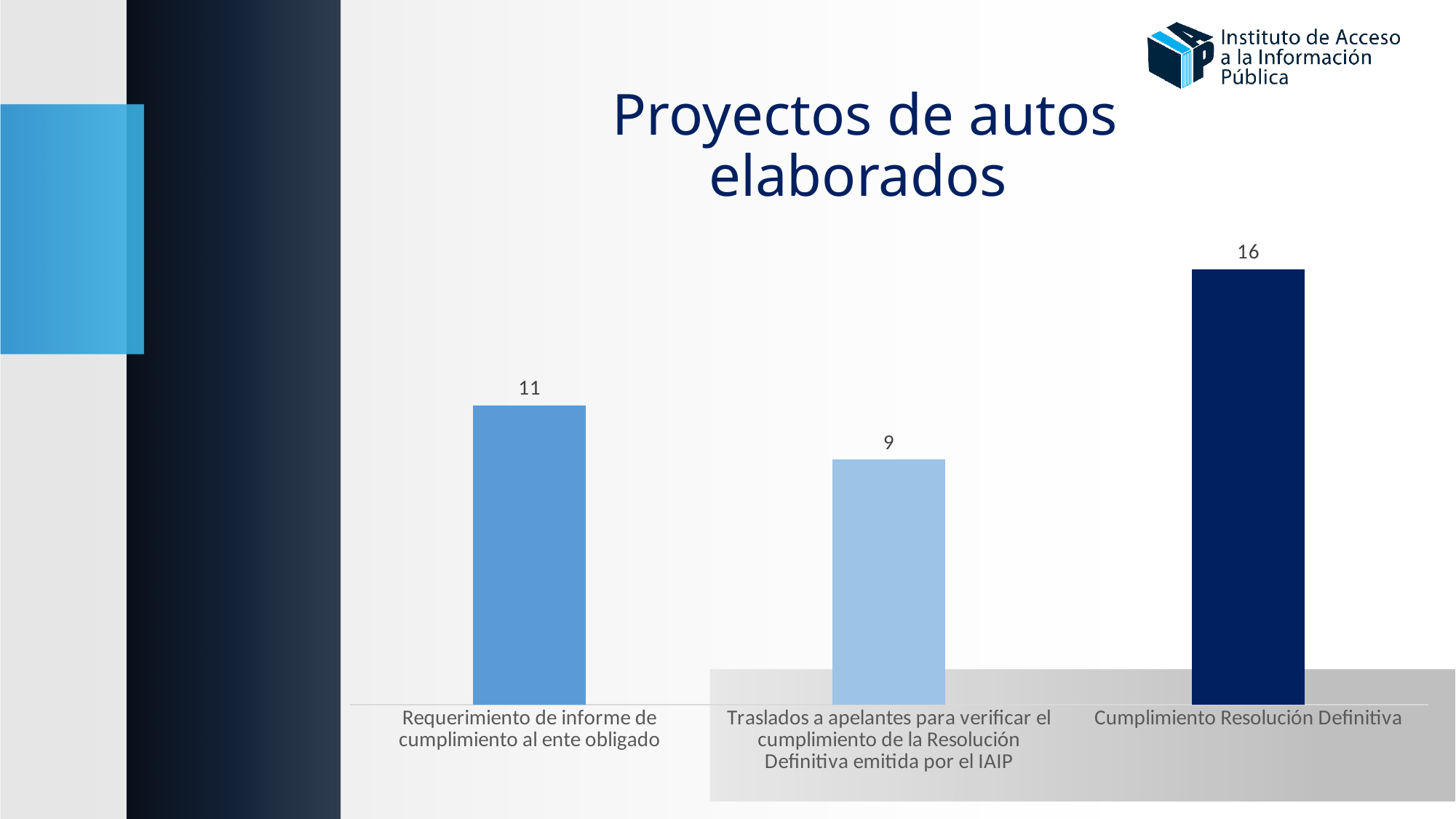
Which category has the highest value? Cumplimiento Resolución Definitiva What is the total of all three bars in the chart? 36 How many categories are shown in the chart? 3 What is the difference between the values for Requerimiento de informe de cumplimiento al ente obligado and Traslados a apelantes para verificar el cumplimiento de la Resolución Definitiva emitida por el IAIP? 2 What is the value for Cumplimiento Resolución Definitiva? 16 Which is larger: the value for Requerimiento de informe de cumplimiento al ente obligado or the value for Traslados a apelantes para verificar el cumplimiento de la Resolución Definitiva emitida por el IAIP? Requerimiento de informe de cumplimiento al ente obligado What is the value for Traslados a apelantes para verificar el cumplimiento de la Resolución Definitiva emitida por el IAIP? 9 What is the title of the slide? Proyectos de autos elaborados What kind of chart is shown on the slide? Bar chart What is the difference between the values for Cumplimiento Resolución Definitiva and Requerimiento de informe de cumplimiento al ente obligado? 5 Which category has the lowest value? Traslados a apelantes para verificar el cumplimiento de la Resolución Definitiva emitida por el IAIP What is the value for Requerimiento de informe de cumplimiento al ente obligado? 11